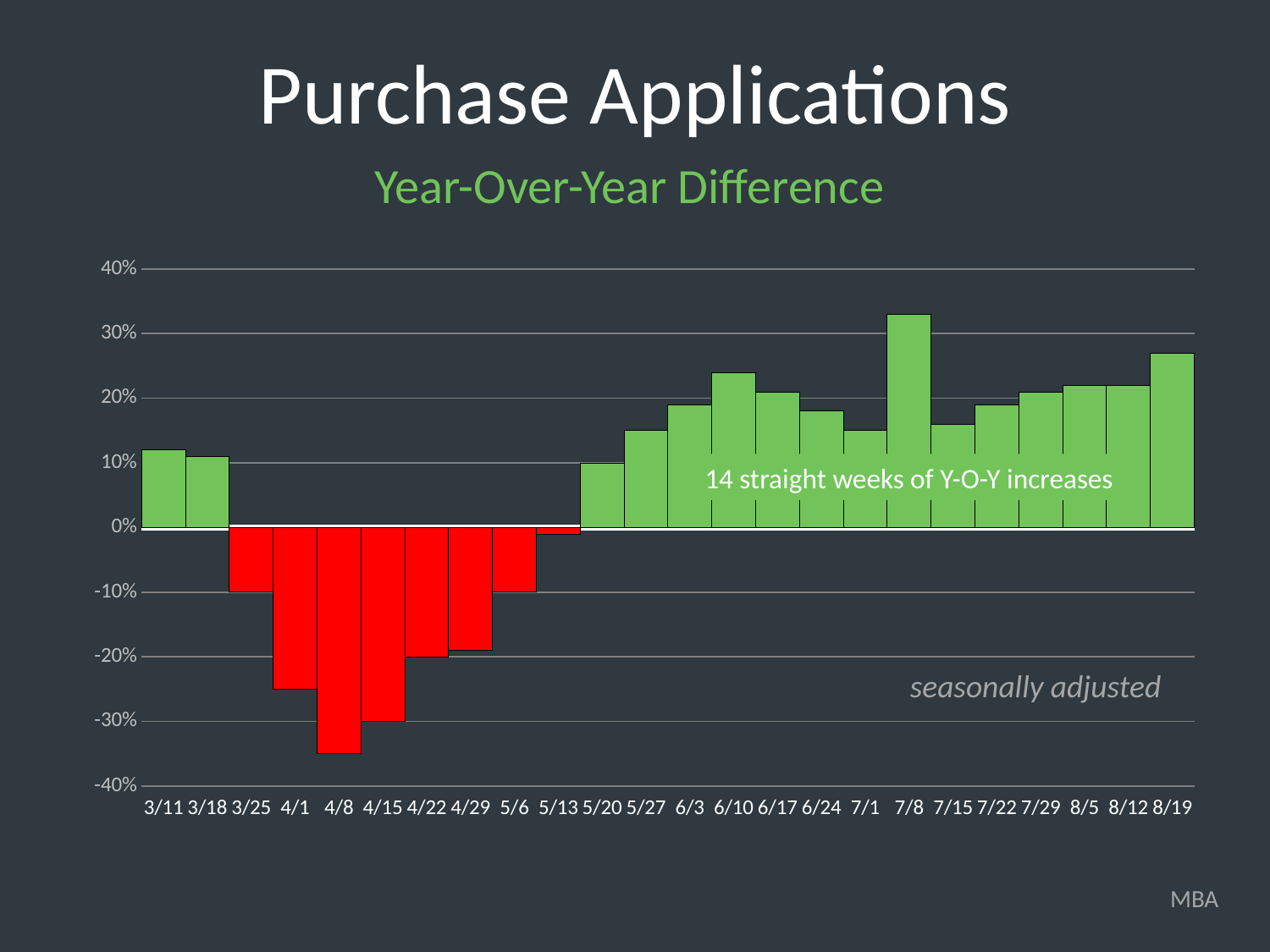
Do the values rise or fall from 4/8 to 6/10? rise Is the value for 6/10 greater or less than 20%? greater Is the value for 4/8 greater or less than -30%? less What kind of chart is shown on the slide? bar chart How many weekly categories are shown on the x axis? 24 Which week has the larger value, 7/8 or 8/19? 7/8 How many bars are shown in red (negative values)? 8 Is the value for 7/8 greater or less than 30%? greater Which week has the lowest year-over-year difference? 4/8 Which week has the highest year-over-year difference? 7/8 What annotation text is printed over the green bars? 14 straight weeks of Y-O-Y increases